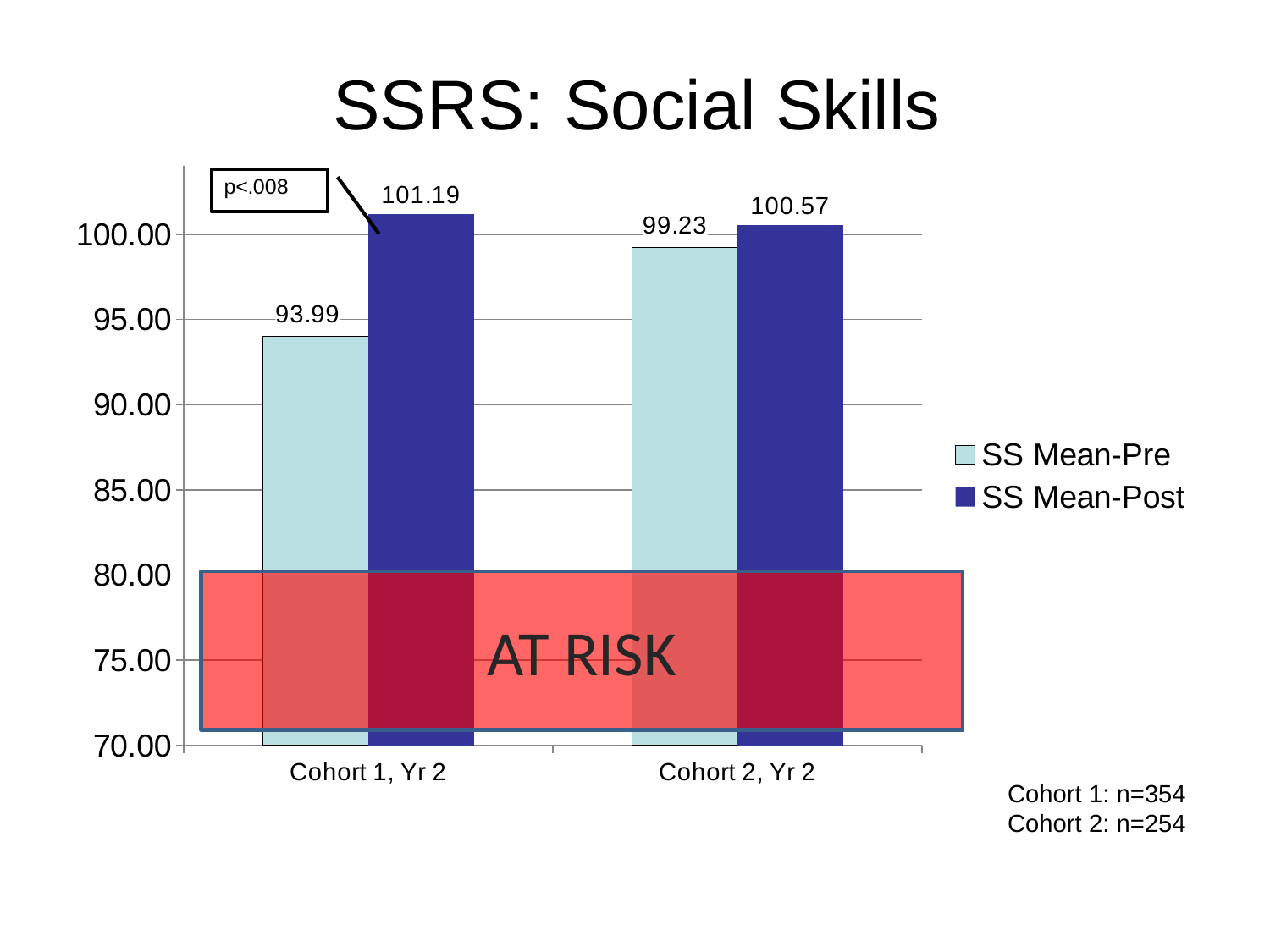
What is the difference between the SS Mean-Post and SS Mean-Pre values for Cohort 2, Yr 2? 1.34 What is the difference between the SS Mean-Post and SS Mean-Pre values for Cohort 1, Yr 2? 7.20 What is the SS Mean-Post value for Cohort 2, Yr 2? 100.57 What is the SS Mean-Pre value for Cohort 2, Yr 2? 99.23 What is the title of the chart? SSRS: Social Skills What kind of chart is shown on the slide? Bar chart How many series does the legend list? 2 Which is larger: the SS Mean-Pre value for Cohort 1, Yr 2 or the SS Mean-Pre value for Cohort 2, Yr 2? Cohort 2, Yr 2 What is the SS Mean-Post value for Cohort 1, Yr 2? 101.19 Which bar has the lowest value on the chart? SS Mean-Pre for Cohort 1, Yr 2 What is the SS Mean-Pre value for Cohort 1, Yr 2? 93.99 Which bar has the highest value on the chart? SS Mean-Post for Cohort 1, Yr 2